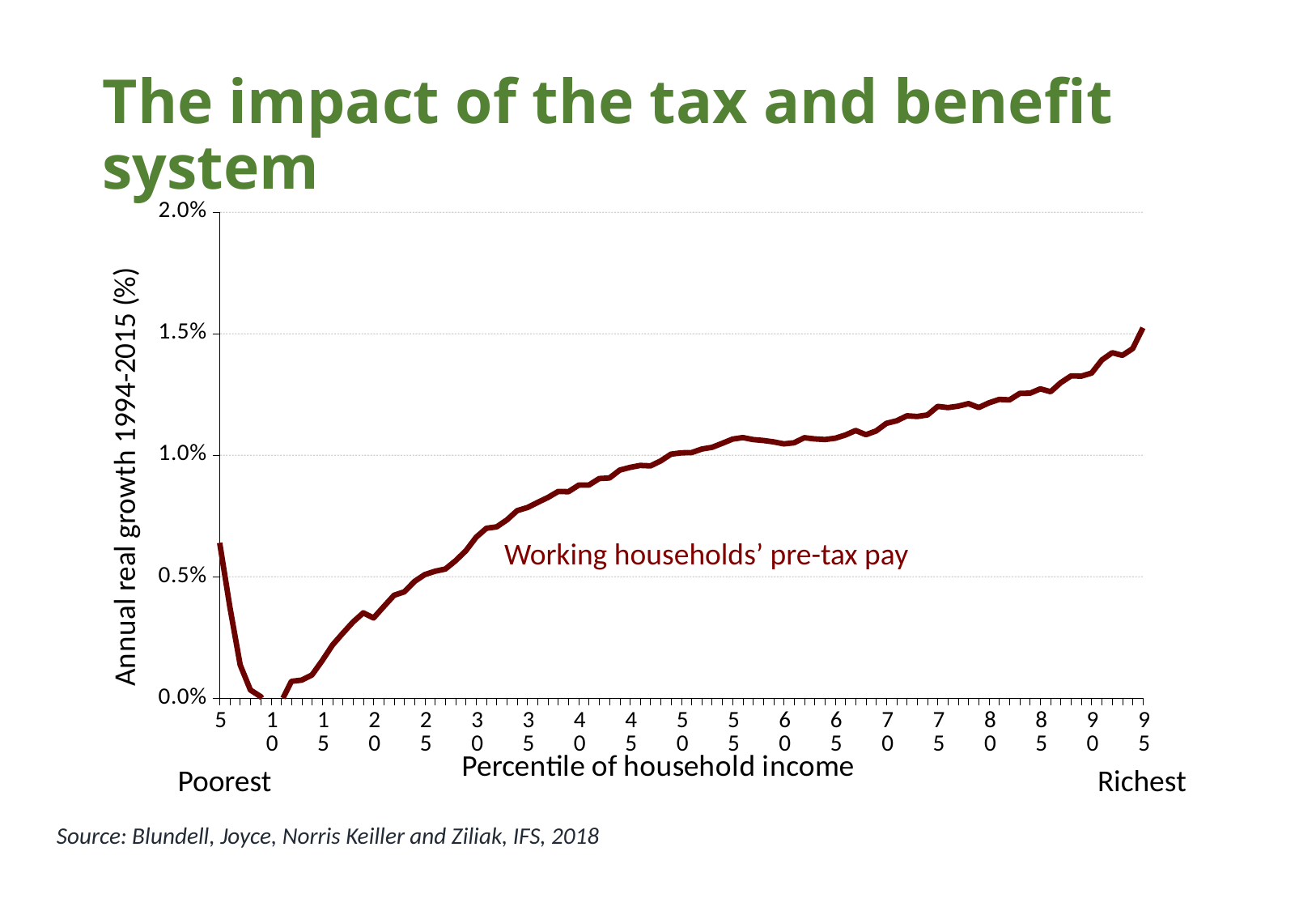
Is the value at the 10th percentile of household income greater or less than 0.5%? less What is the title of the slide's chart? The impact of the tax and benefit system Is the value at the 5th percentile of household income greater or less than 1.0%? less At which percentile of household income is annual real growth highest? 95 What kind of chart is shown on the slide? line chart Does annual real growth rise or fall as the percentile of household income increases from 10 to 95? rise Is the value at the 30th percentile of household income greater or less than 0.5%? greater What series label is printed on the chart line? Working households' pre-tax pay Which has the higher annual real growth: the 95th percentile or the 50th percentile? 95th percentile